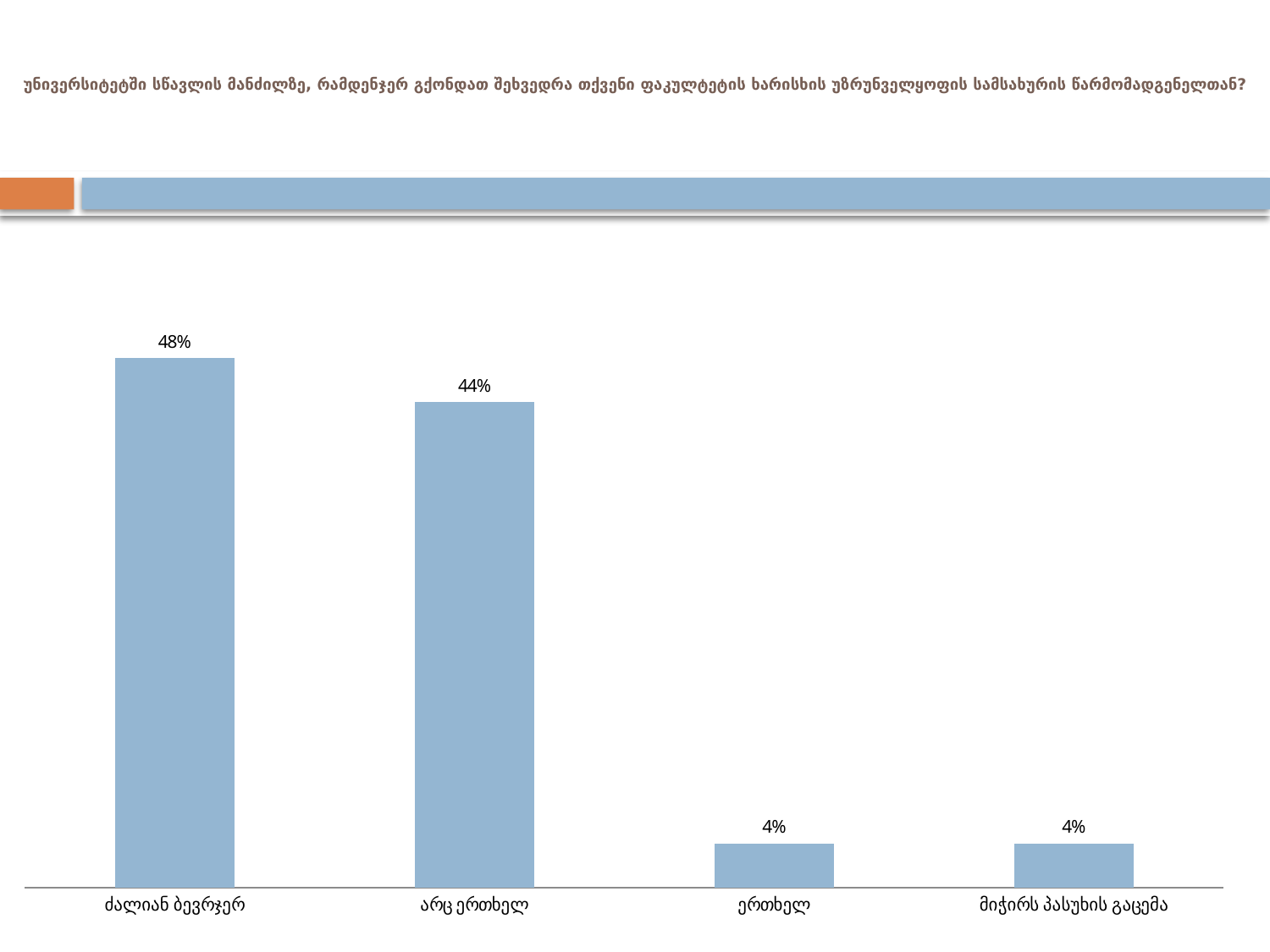
Which category has the highest value? ძალიან ბევრჯერ What is the value for მიჭირს პასუხის გაცემა? 4% What is the value for ერთხელ? 4% What is the value for ძალიან ბევრჯერ? 48% Which is larger, the value for ძალიან ბევრჯერ or the value for არც ერთხელ? ძალიან ბევრჯერ What is the value for არც ერთხელ? 44% What is the difference between the values for ძალიან ბევრჯერ and არც ერთხელ? 4% What colour are the bars in the chart? Light blue How many categories are shown in the chart? 4 What is the difference between the values for არც ერთხელ and ერთხელ? 40% What kind of chart is shown on the slide? Bar chart Which is larger, the value for არც ერთხელ or the value for მიჭირს პასუხის გაცემა? არც ერთხელ